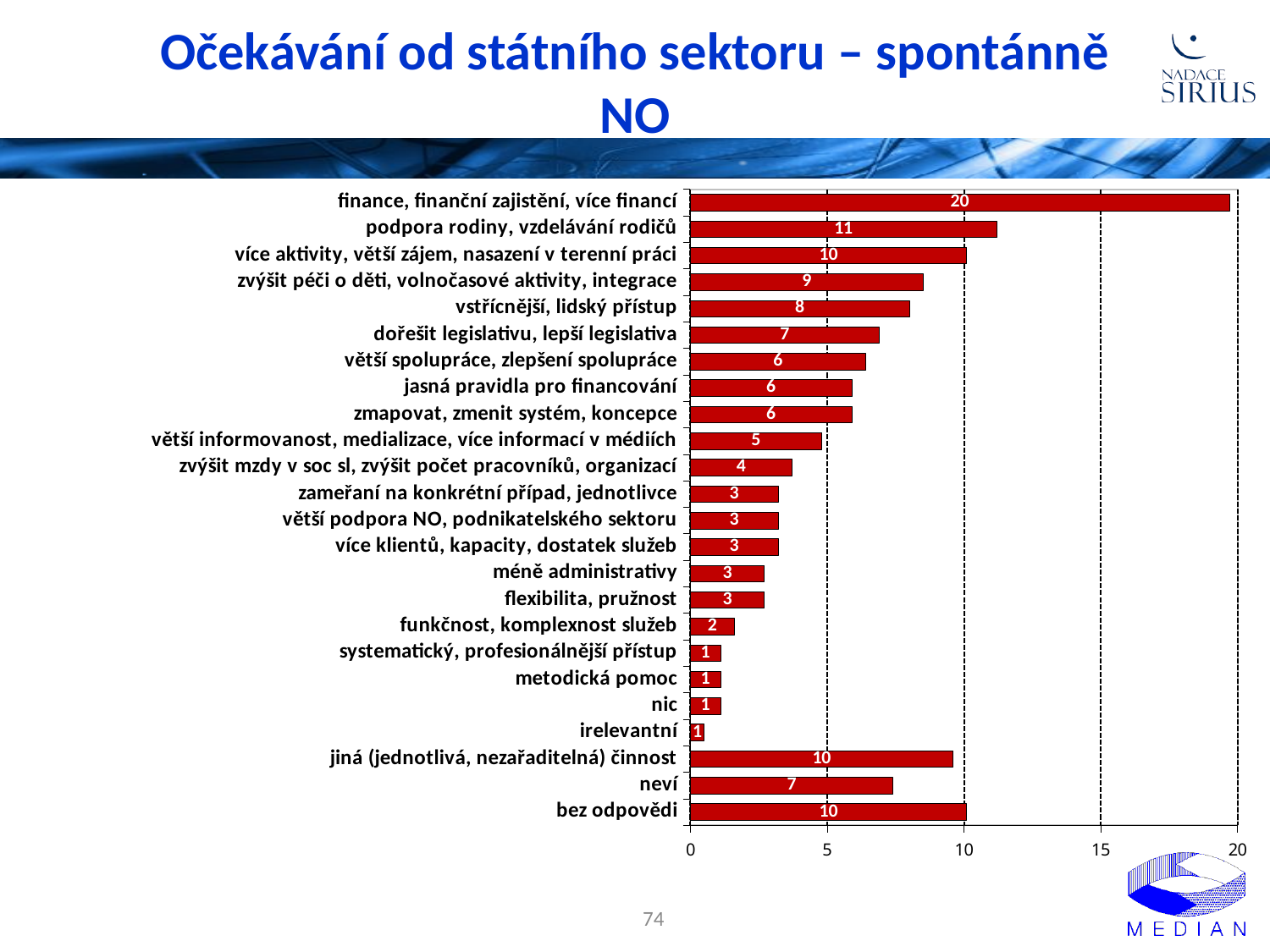
What is the value for 'vstřícnější, lidský přístup'? 8 What is the value for 'neví'? 7 What is the value for 'podpora rodiny, vzdelávání rodičů'? 11 How many categories are shown in the chart? 24 What is the value for 'funkčnost, komplexnost služeb'? 2 What is the title of the slide? Očekávání od státního sektoru – spontánně NO What is the difference between the values for 'finance, finanční zajištění, více financí' and 'podpora rodiny, vzdelávání rodičů'? 9 Which is larger: the value for 'dořešit legislativu, lepší legislativa' or the value for 'větší informovanost, medializace, více informací v médiích'? dořešit legislativu, lepší legislativa Is the value for 'zvýšit péči o děti, volnočasové aktivity, integrace' greater or less than 5? greater What type of chart is shown on the slide? bar chart Which category has the highest value? finance, finanční zajištění, více financí What is the value for 'finance, finanční zajištění, více financí'? 20